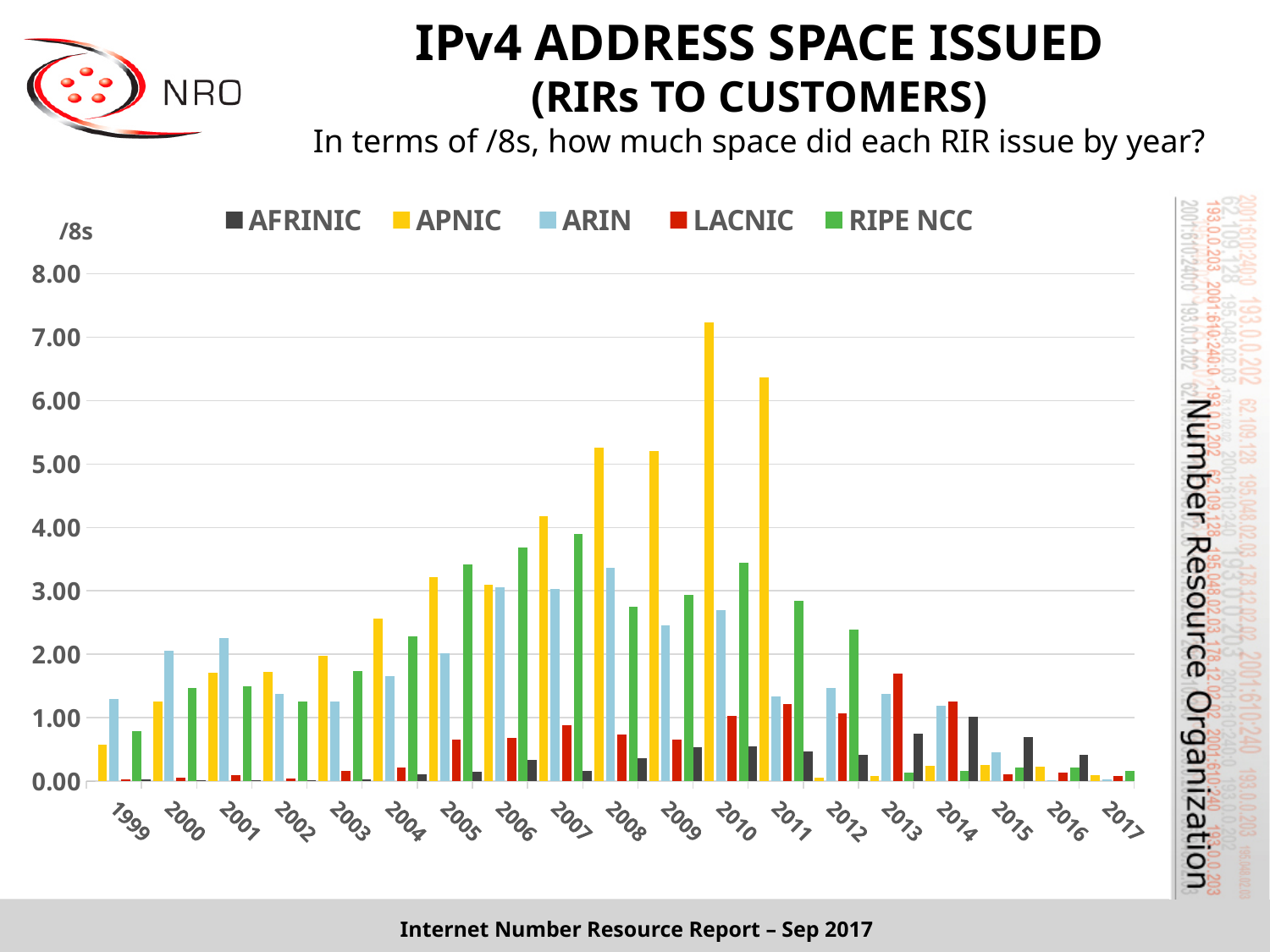
Is the value for LACNIC in 2013 greater or less than 1.00? greater How many series does the legend list? 5 How many years are shown along the x axis? 19 In which year is the APNIC bar the tallest? 2010 Is the value for APNIC in 2010 greater or less than 7.00? greater Which RIR has the single tallest bar in the chart? APNIC Which is larger, the ARIN value in 2008 or the RIPE NCC value in 2008? ARIN What unit label is shown at the top of the y axis? /8s What kind of chart is shown on the slide? bar chart Do the APNIC values rise or fall from 2011 to 2017? fall Is the value for RIPE NCC in 2006 greater or less than 3.00? greater